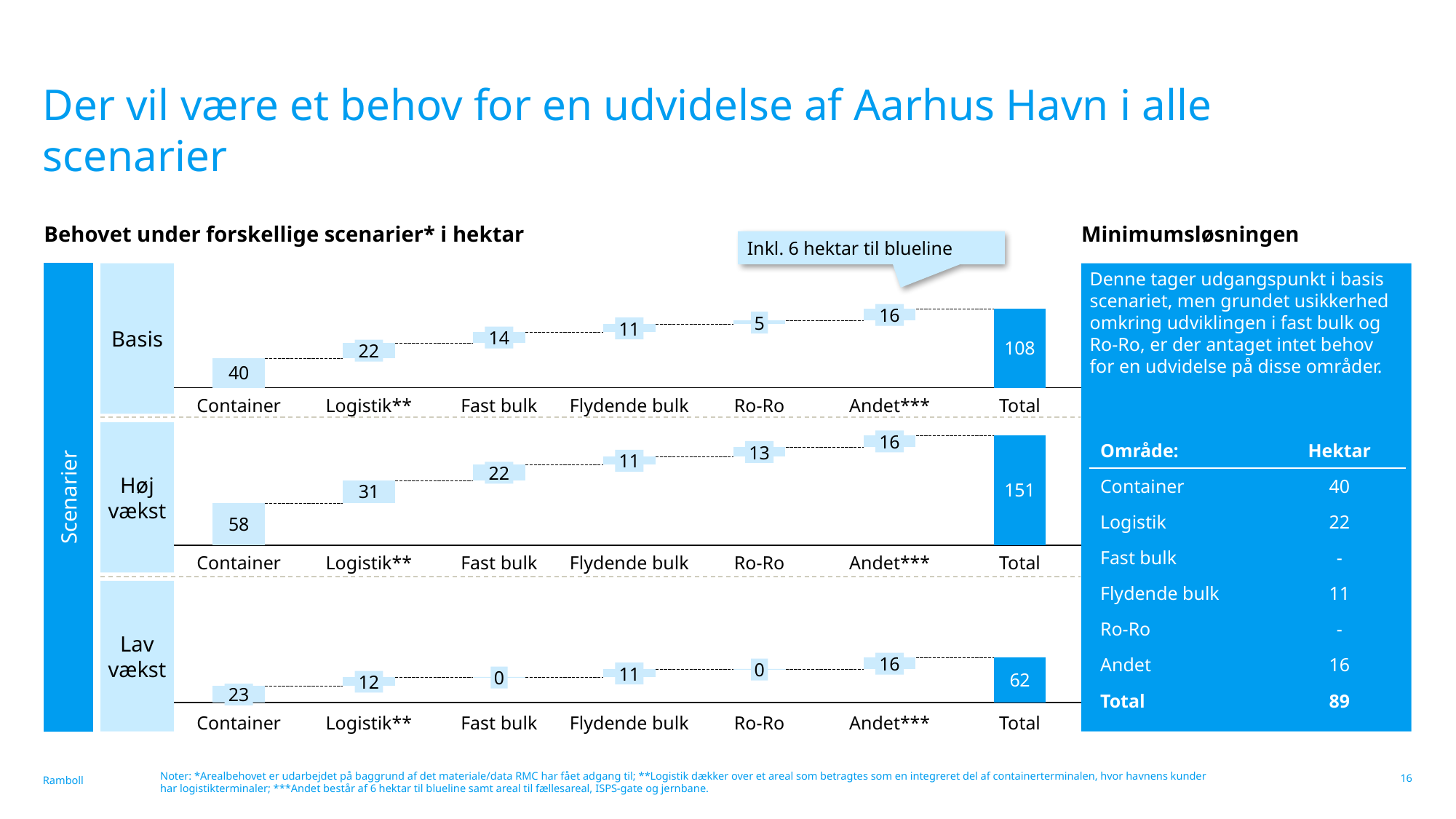
In the Lav vækst chart, what is the value for Fast bulk? 0 In the Basis chart, what is the value for Container? 40 Which is larger: the Total in the Basis chart or the Total in the Lav vækst chart? Basis In the Høj vækst chart, what is the value for Logistik**? 31 What kind of chart is used for the Basis scenario? Waterfall chart In the Basis chart, which category (excluding Total) has the highest value? Container In the Høj vækst chart, what is the Total value? 151 In the Basis chart, which category has the lowest value? Ro-Ro In the Lav vækst chart, how many categories are shown on the x axis, including Total? 7 In the Høj vækst chart, what is the difference between Container and Logistik**? 27 What is the title of the chart area on the left of the slide? Behovet under forskellige scenarier* i hektar In the Basis chart, what is the difference between the Total and the Container value? 68